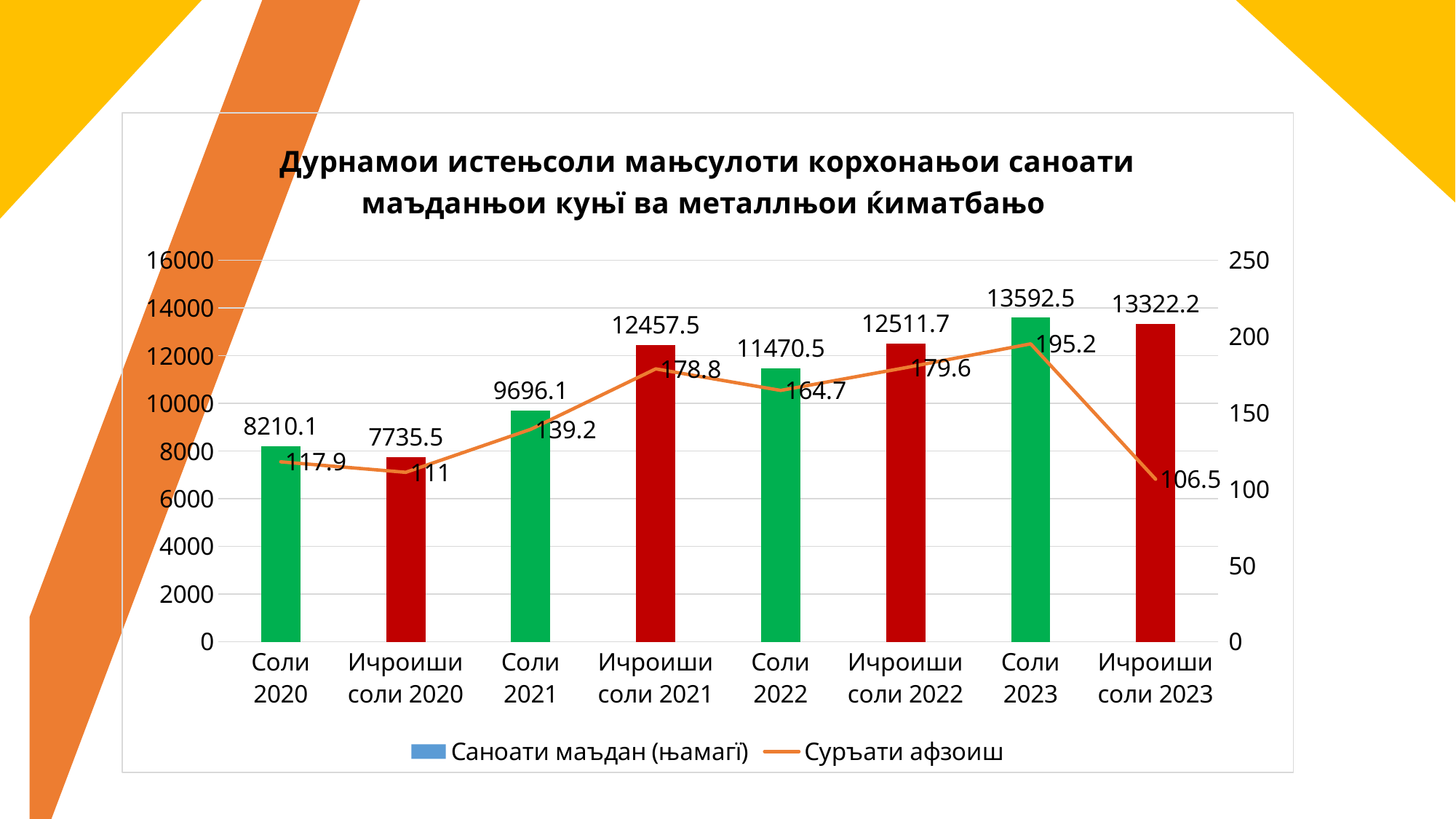
What is the value of the Саноати маъдан (ҳамагӣ) bar for Иҷроиши соли 2022? 12511.7 How many categories are shown on the x axis? 8 What kind of chart is shown on the slide? Combined bar and line chart What is the Суръати афзоиш value for Соли 2023? 195.2 Which category has the highest Саноати маъдан (ҳамагӣ) bar? Соли 2023 Which category has the lowest Суръати афзоиш value? Иҷроиши соли 2023 What is the difference between the Саноати маъдан (ҳамагӣ) bars for Соли 2023 and Иҷроиши соли 2023? 270.3 How many series does the legend list? 2 What is the Суръати афзоиш value for Иҷроиши соли 2023? 106.5 Which is larger, the Саноати маъдан (ҳамагӣ) bar for Соли 2021 or for Иҷроиши соли 2021? Иҷроиши соли 2021 What is the value of the Саноати маъдан (ҳамагӣ) bar for Соли 2020? 8210.1 Which category has the lowest Саноати маъдан (ҳамагӣ) bar? Иҷроиши соли 2020